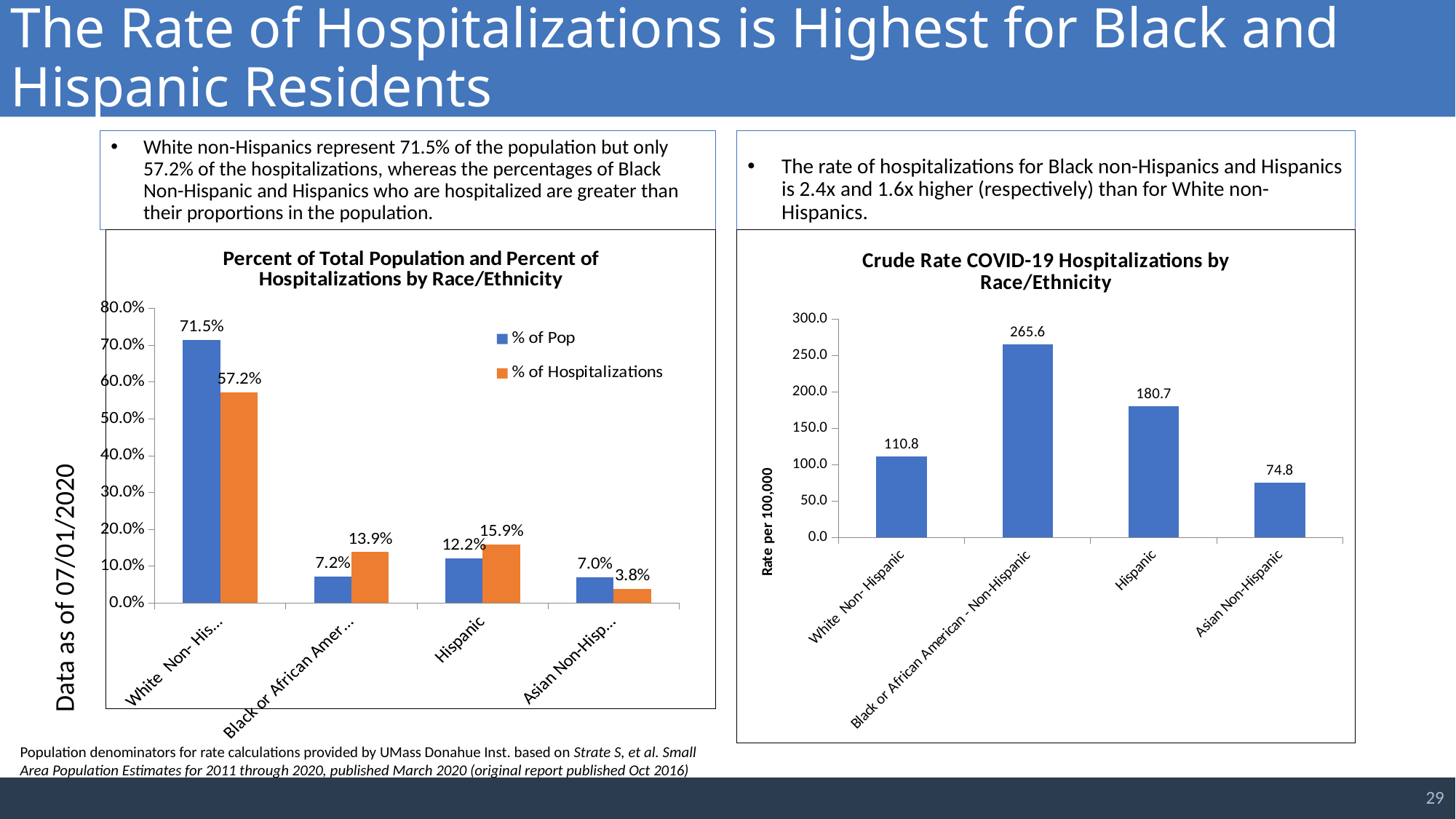
In the chart titled 'Crude Rate COVID-19 Hospitalizations by Race/Ethnicity', what is the difference between the rates for Black or African American - Non-Hispanic and White Non-Hispanic? 154.8 In the chart titled 'Percent of Total Population and Percent of Hospitalizations by Race/Ethnicity', which is larger for Hispanic: % of Pop or % of Hospitalizations? % of Hospitalizations In the chart titled 'Percent of Total Population and Percent of Hospitalizations by Race/Ethnicity', what is the % of Pop value for Hispanic? 12.2% In the chart titled 'Crude Rate COVID-19 Hospitalizations by Race/Ethnicity', what is the rate for Hispanic? 180.7 In the chart titled 'Crude Rate COVID-19 Hospitalizations by Race/Ethnicity', how many categories are shown? 4 In the chart titled 'Percent of Total Population and Percent of Hospitalizations by Race/Ethnicity', what is the difference between the % of Pop and % of Hospitalizations values for the White Non-Hispanic category? 14.3% What kind of chart is the chart titled 'Crude Rate COVID-19 Hospitalizations by Race/Ethnicity'? Bar chart In the chart titled 'Percent of Total Population and Percent of Hospitalizations by Race/Ethnicity', how many series does the legend list? 2 In the chart titled 'Percent of Total Population and Percent of Hospitalizations by Race/Ethnicity', what is the % of Hospitalizations value for Hispanic? 15.9% In the chart titled 'Crude Rate COVID-19 Hospitalizations by Race/Ethnicity', which category has the lowest rate? Asian Non-Hispanic In the chart titled 'Crude Rate COVID-19 Hospitalizations by Race/Ethnicity', which category has the highest rate? Black or African American - Non-Hispanic In the chart titled 'Crude Rate COVID-19 Hospitalizations by Race/Ethnicity', what is the rate for Black or African American - Non-Hispanic? 265.6